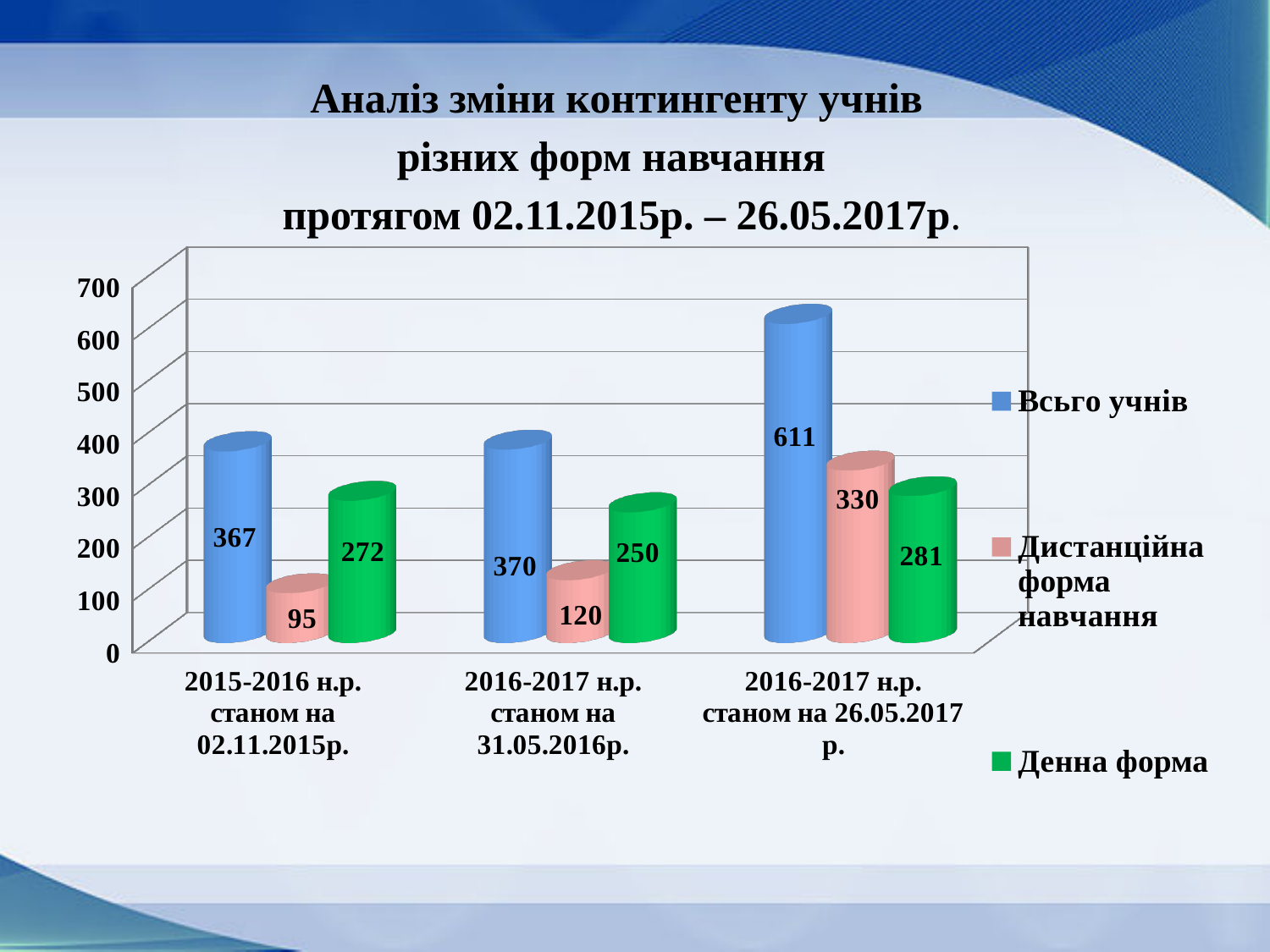
In which category is the value for "Дистанційна форма навчання" lowest? 2015-2016 н.р. станом на 02.11.2015р. How many categories are shown on the x axis? 3 Do the values for "Дистанційна форма навчання" rise or fall across the categories from left to right? Rise What is the value for "Дистанційна форма навчання" in the category "2016-2017 н.р. станом на 31.05.2016р."? 120 What is the value for "Денна форма" in the category "2016-2017 н.р. станом на 26.05.2017 р."? 281 Which colour represents the series "Денна форма" in the legend? Green In which category is the value for "Всього учнів" highest? 2016-2017 н.р. станом на 26.05.2017 р. What kind of chart is shown on the slide? Bar chart How many series does the legend list? 3 What is the difference between "Всього учнів" in "2016-2017 н.р. станом на 26.05.2017 р." and in "2016-2017 н.р. станом на 31.05.2016р."? 241 Which is larger in the category "2015-2016 н.р. станом на 02.11.2015р.": "Дистанційна форма навчання" or "Денна форма"? Денна форма What is the value for "Всього учнів" in the category "2015-2016 н.р. станом на 02.11.2015р."? 367